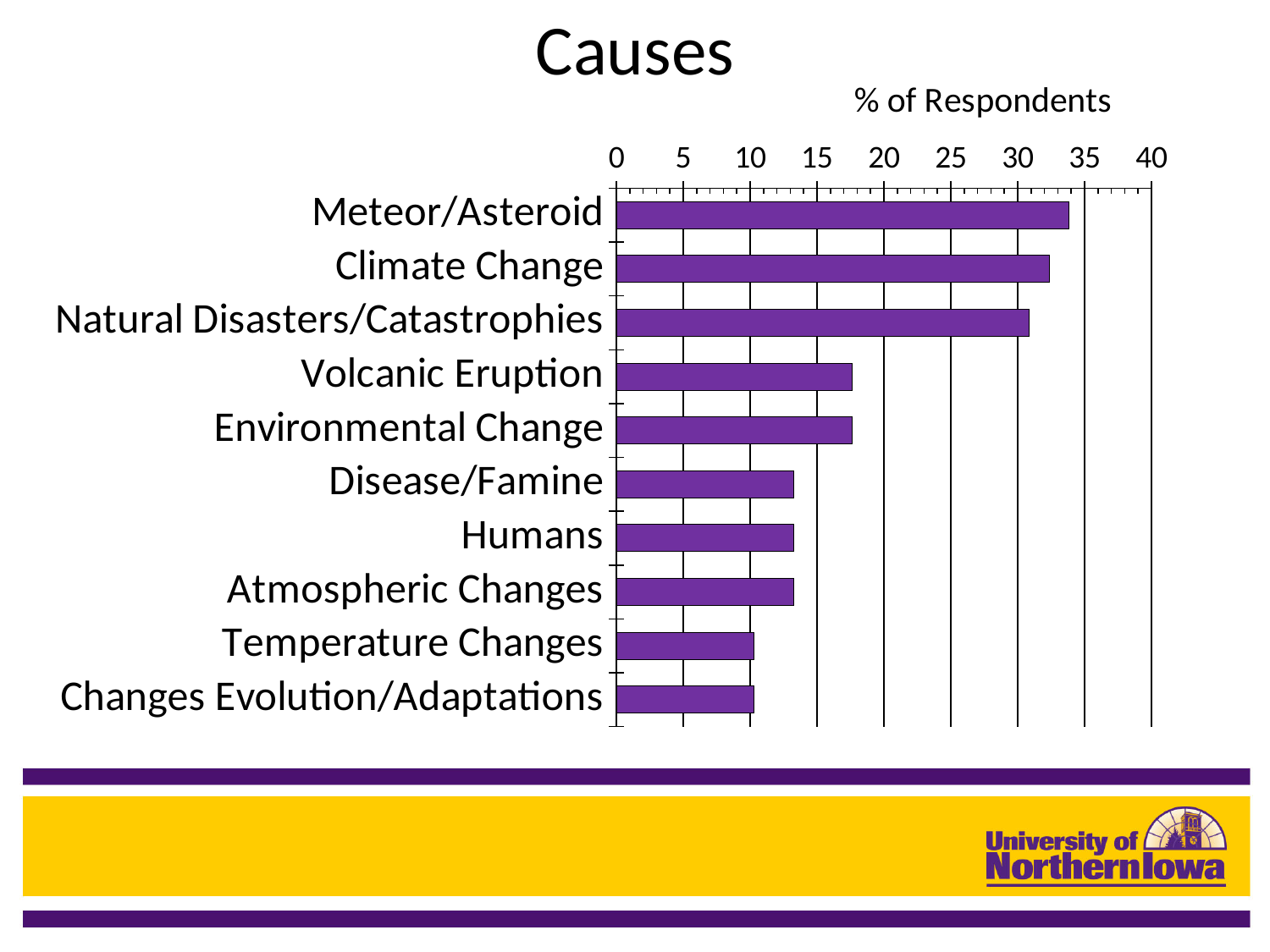
Is the value for Volcanic Eruption greater or less than 15? greater What is the label on the value axis of the chart? % of Respondents What kind of chart is shown on the slide? bar chart Is the value for Natural Disasters/Catastrophies greater or less than 25? greater Which has a higher percentage of respondents, Meteor/Asteroid or Volcanic Eruption? Meteor/Asteroid Is the value for Disease/Famine greater or less than 15? less Which cause has the highest percentage of respondents? Meteor/Asteroid Which has a higher percentage of respondents, Humans or Natural Disasters/Catastrophies? Natural Disasters/Catastrophies How many categories (causes) are plotted in the chart? 10